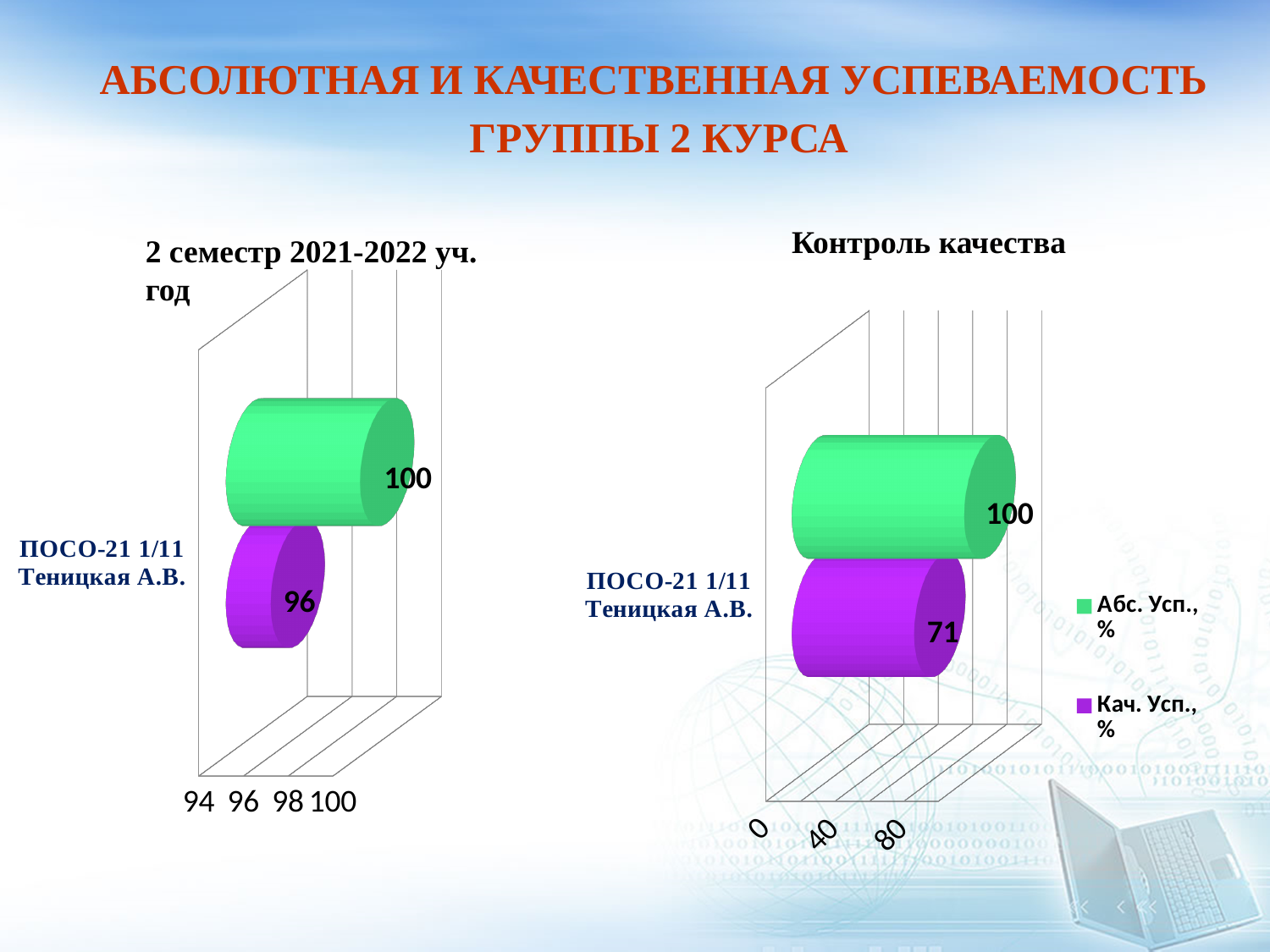
In the chart titled "Контроль качества", is the value for Кач. Усп., % greater or less than 80? less In the chart titled "2 семестр 2021-2022 уч. год", what is the category label shown on the axis? ПОСО-21 1/11 Теницкая А.В. In the chart titled "2 семестр 2021-2022 уч. год", what value is labelled on the green bar? 100 In the chart titled "Контроль качества", what is the value for Абс. Усп., %? 100 In the chart titled "Контроль качества", how many series does the legend list? 2 In the chart titled "Контроль качества", what colour is the bar for Кач. Усп., %? purple In the chart titled "2 семестр 2021-2022 уч. год", what kind of chart is shown? bar chart In the chart titled "Контроль качества", what is the difference between Абс. Усп., % and Кач. Усп., %? 29 In the chart titled "2 семестр 2021-2022 уч. год", what value is labelled on the purple bar? 96 In the chart titled "Контроль качества", what is the value for Кач. Усп., %? 71 In the chart titled "2 семестр 2021-2022 уч. год", what is the difference between the green bar and the purple bar? 4 In the chart titled "Контроль качества", which series has the larger value, Абс. Усп., % or Кач. Усп., %? Абс. Усп., %